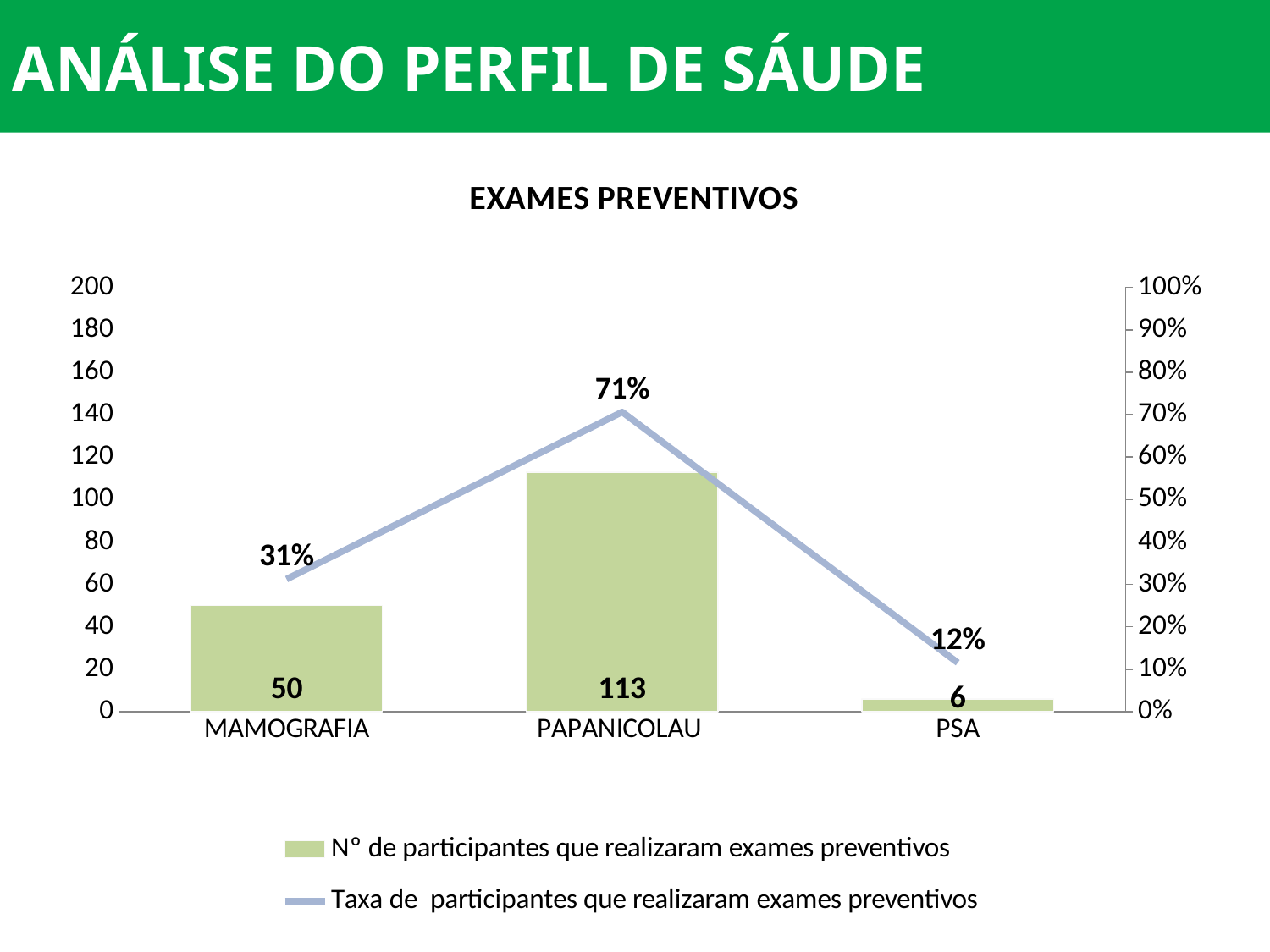
What is the number of participants who had a MAMOGRAFIA exam? 50 Which has a higher rate of participants, MAMOGRAFIA or PSA? MAMOGRAFIA What is the rate (Taxa) of participants who had a PSA exam? 12% What is the title of the chart? EXAMES PREVENTIVOS Which exam has the highest number of participants? PAPANICOLAU What is the number of participants who had a PAPANICOLAU exam? 113 How many series does the legend list? 2 What is the difference in number of participants between PAPANICOLAU and MAMOGRAFIA? 63 How many exam categories are shown on the x axis? 3 What is the rate (Taxa) of participants who had a PAPANICOLAU exam? 71% What is the maximum value shown on the right-hand axis? 100% Which exam has the lowest rate of participants? PSA